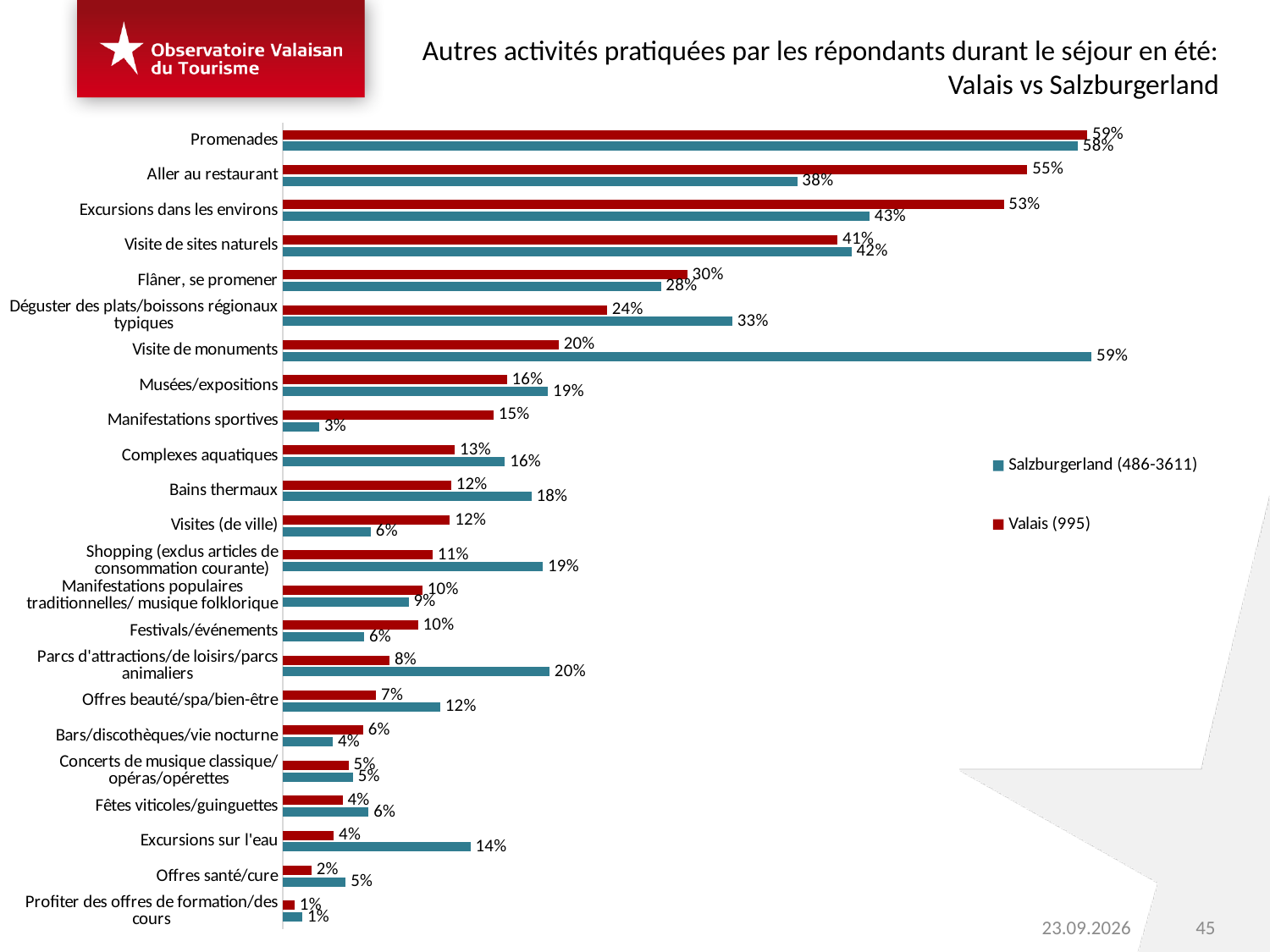
What is the value for Salzburgerland for 'Excursions sur l'eau'? 14% What is the difference between the Valais and Salzburgerland values for 'Manifestations sportives'? 12% What is the sample size shown in the legend for Valais? 995 What is the difference between the Salzburgerland and Valais values for 'Visite de monuments'? 39% Which activity has the lowest value for Salzburgerland? Profiter des offres de formation/des cours What type of chart is shown on the slide? Bar chart What is the value for Valais for 'Aller au restaurant'? 55% For 'Parcs d'attractions/de loisirs/parcs animaliers', which is larger: the Valais value or the Salzburgerland value? Salzburgerland Which activity has the highest value for Valais? Promenades What is the value for Salzburgerland for 'Visite de monuments'? 59% How many activity categories are shown in the chart? 23 How many series does the legend list? 2